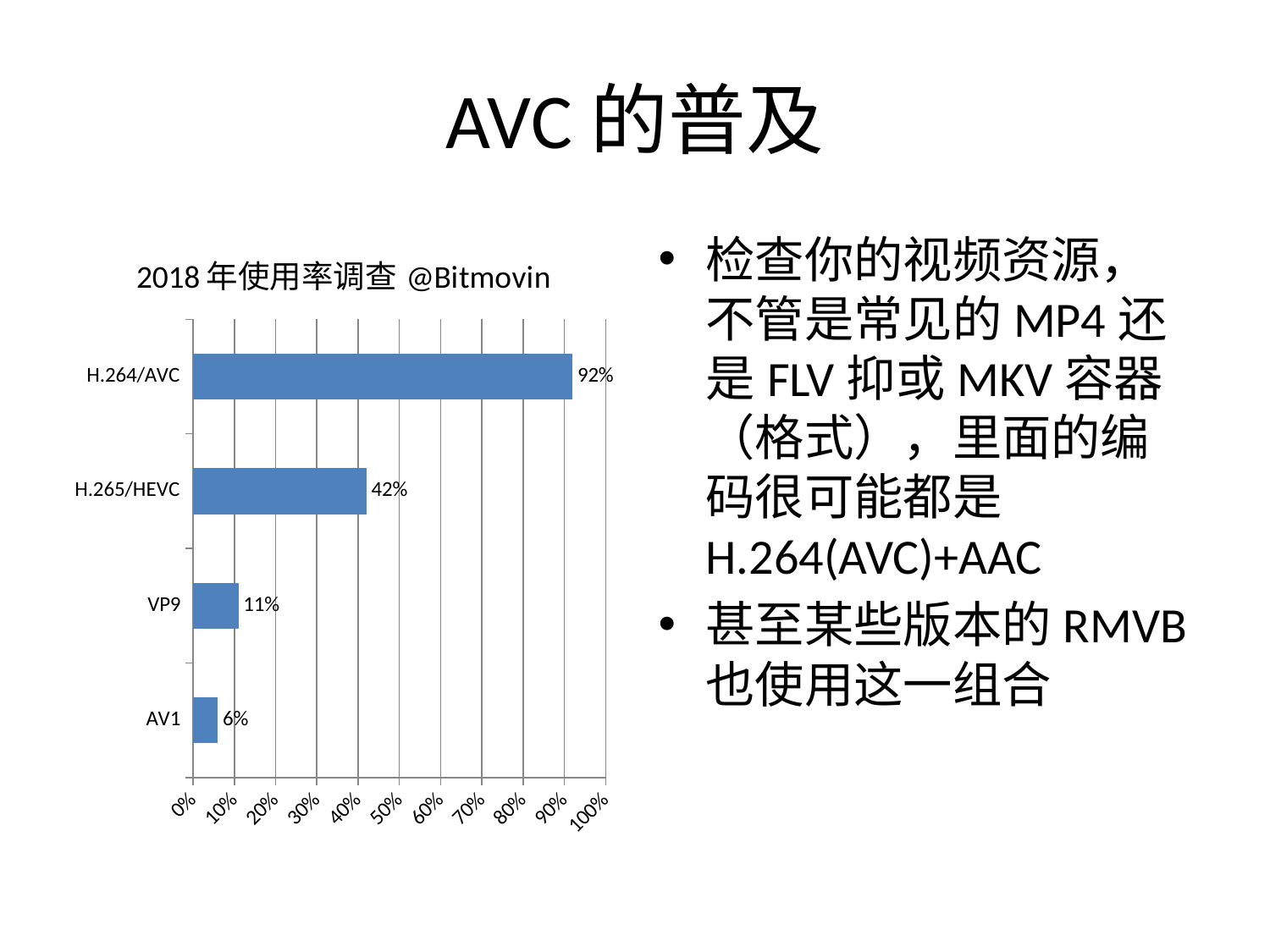
What is the difference between the values for VP9 and AV1? 5% What is the value for VP9? 11% How many categories are shown in the chart? 4 What is the value for H.265/HEVC? 42% Which category has the lowest value? AV1 What is the difference between the values for H.264/AVC and H.265/HEVC? 50% What kind of chart is shown on the slide? bar chart What is the value for AV1? 6% Is the value for H.265/HEVC greater or less than 50%? less Which is larger, the value for H.265/HEVC or the value for VP9? H.265/HEVC What is the value for H.264/AVC? 92% Which category has the highest value? H.264/AVC